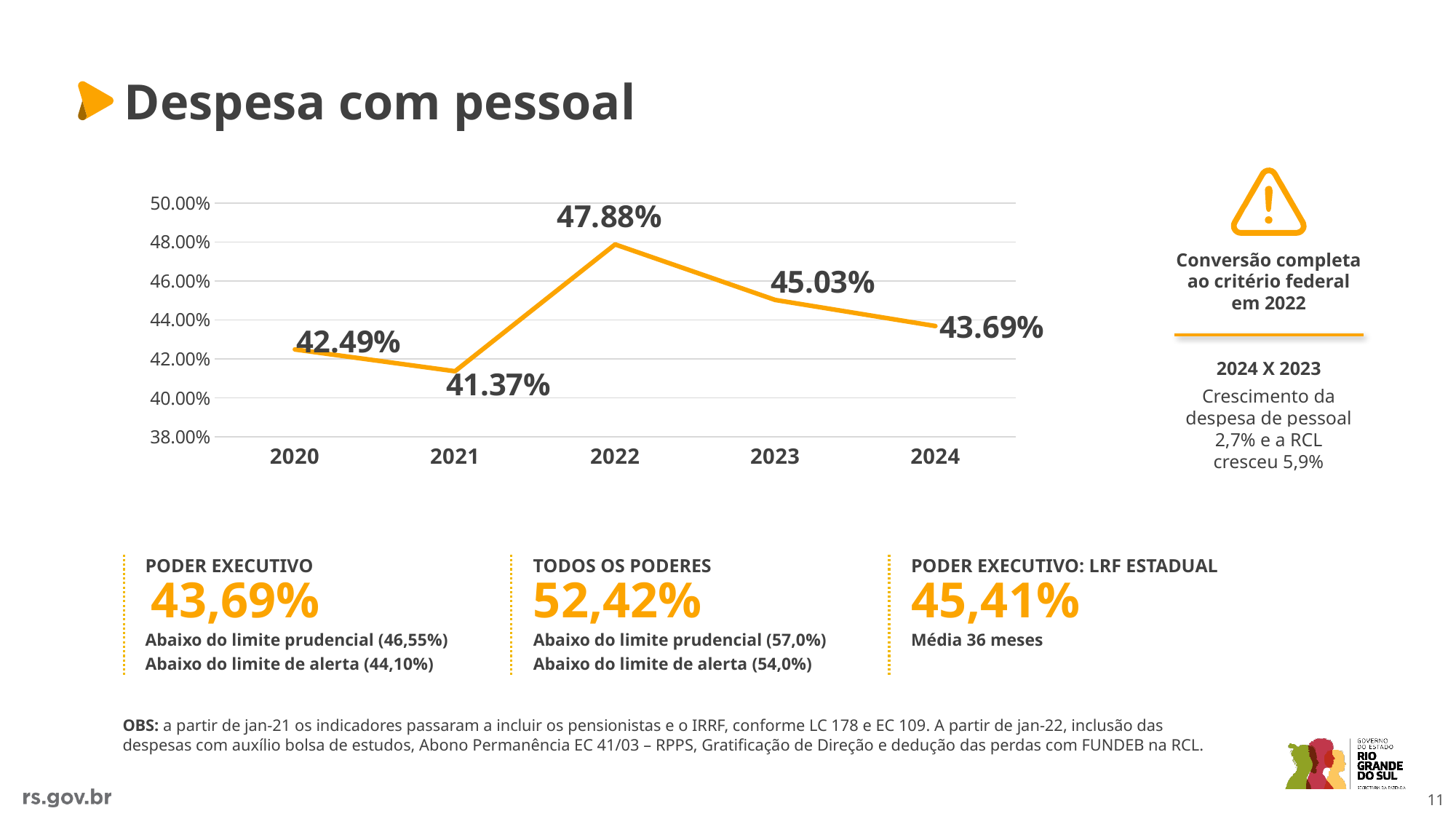
What is the value plotted for 2021 in the line chart? 41.37% Do the values in the line chart rise or fall from 2022 to 2024? fall Which year has the lowest value in the line chart? 2021 What is the value plotted for 2022 in the line chart? 47.88% Which year has the highest value in the line chart? 2022 How many years are plotted on the x axis of the line chart? 5 What is the difference between the 2023 value and the 2024 value in the line chart? 1.34 percentage points What is the difference between the 2022 value and the 2021 value in the line chart? 6.51 percentage points What is the value plotted for 2024 in the line chart? 43.69% Which year has the larger value in the line chart, 2020 or 2023? 2023 What kind of chart is shown on the slide? line chart Is the value for 2021 in the line chart greater or less than 42.00%? less